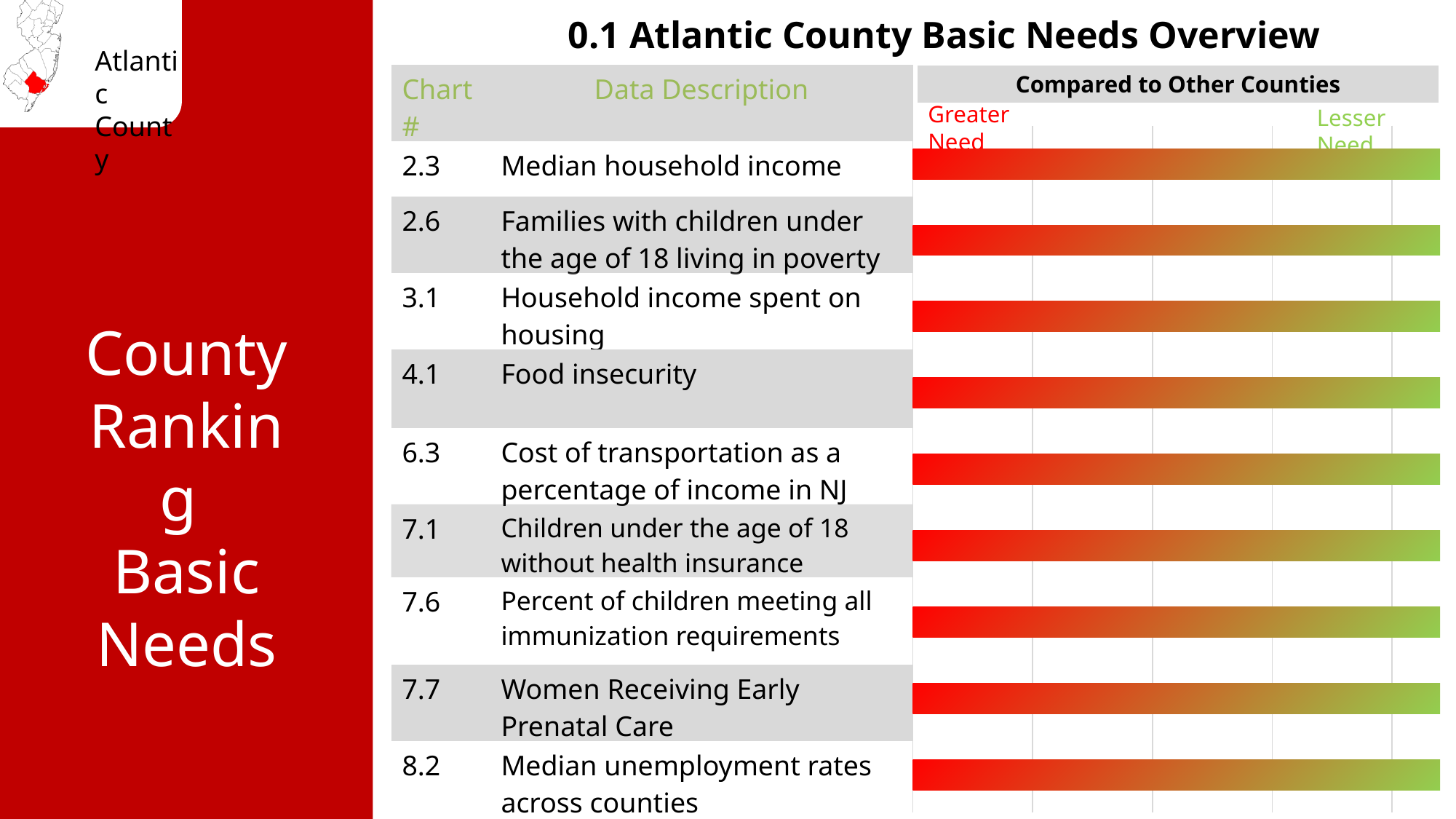
What is the title of the chart on the right side of the slide? Compared to Other Counties What label appears at the left end of the chart's scale, and what label appears at the right end? Greater Need (left), Lesser Need (right) Which data description corresponds to chart number 4.1 in the table? Food insecurity Which chart number is listed for "Women Receiving Early Prenatal Care"? 7.7 What kind of chart is shown under the heading "Compared to Other Counties"? bar chart Which chart number is listed for "Median unemployment rates across counties"? 8.2 What is the data description for chart number 2.3? Median household income How many bars are plotted in the "Compared to Other Counties" chart? 9